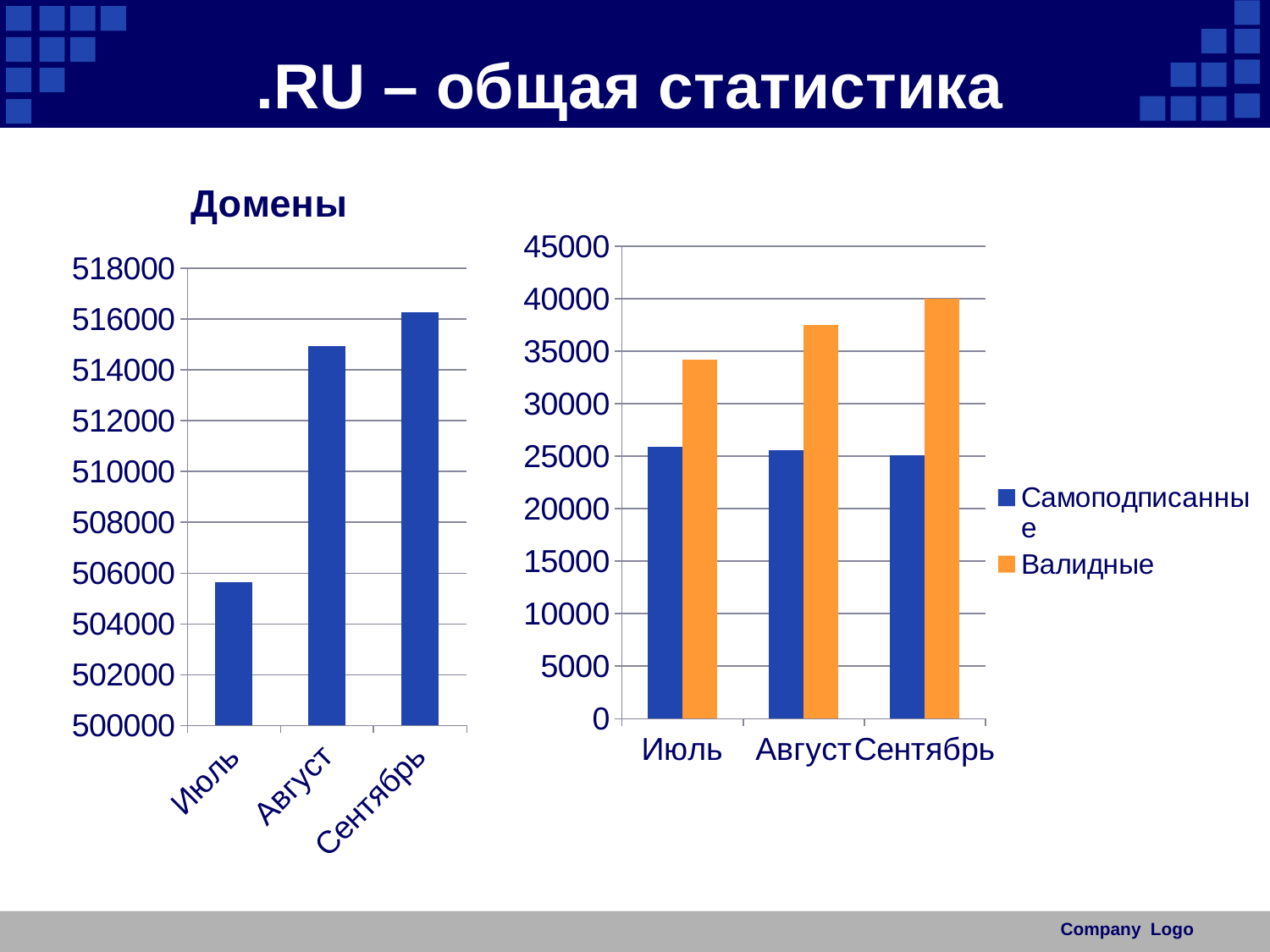
In the "Домены" chart, which month has the highest value? Сентябрь What kind of chart is the "Домены" chart on the left? bar chart How many categories are shown on the x axis of the "Домены" chart? 3 In the "Домены" chart, do the values rise or fall from Июль to Сентябрь? rise In the "Домены" chart, is the value for Август greater or less than 514000? greater In the "Домены" chart, is the value for Июль greater or less than 506000? less In the "Домены" chart, which month has the lowest value? Июль In the chart on the right, which series has the higher value for Сентябрь, Самоподписанные or Валидные? Валидные In the chart on the right, do the Валидные values rise or fall from Июль to Сентябрь? rise How many series does the legend of the chart on the right list? 2 In the chart on the right, is the Валидные value for Июль greater or less than 30000? greater In the chart on the right, what colour are the bars for the Валидные series? orange